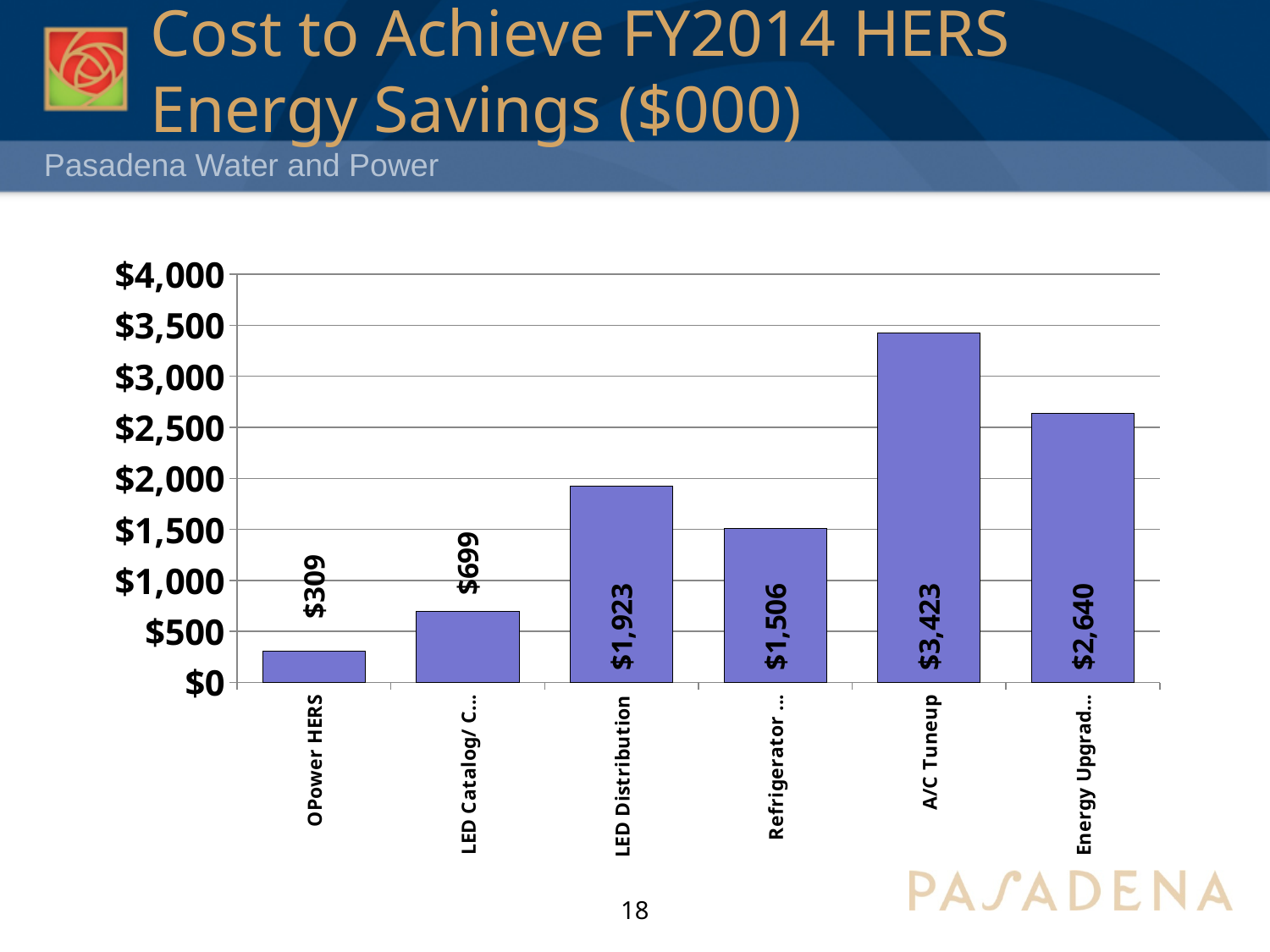
What is the value for OPower HERS? $309 What is the value for A/C Tuneup? $3,423 What is the value for the Refrigerator category? $1,506 Is the value for A/C Tuneup greater or less than $3,000? greater Which category has the highest value? A/C Tuneup What is the difference between the values for LED Distribution and OPower HERS? $1,614 Which is larger, the value for LED Distribution or the value for the Refrigerator category? LED Distribution How many categories are shown in the chart? 6 Which category has the lowest value? OPower HERS What kind of chart is shown on the slide? bar chart What is the value for LED Distribution? $1,923 What is the difference between the values for A/C Tuneup and LED Distribution? $1,500